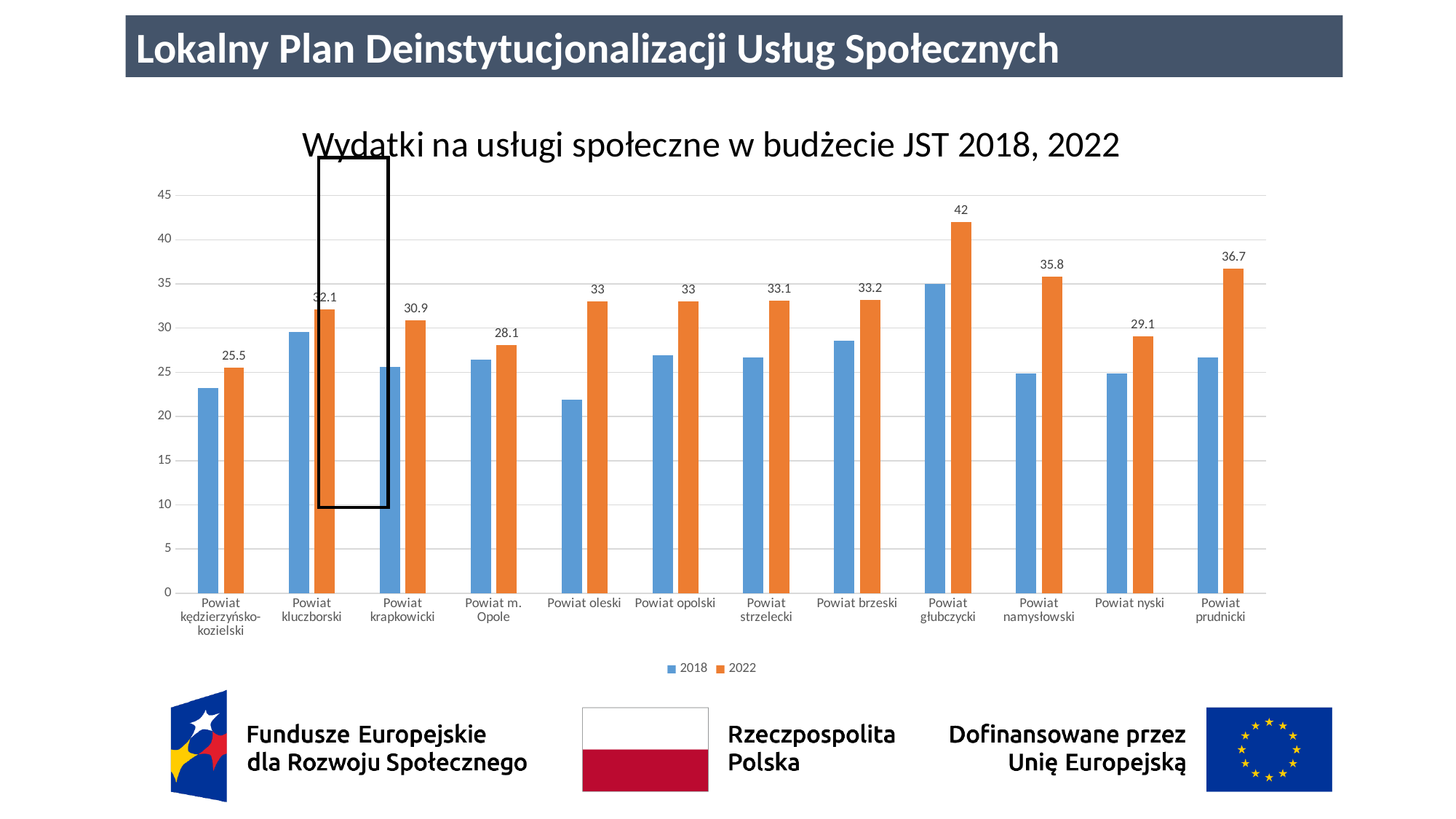
Is the 2018 value for Powiat oleski greater or less than 25? less How many series does the legend list? 2 What is the 2022 value for Powiat nyski? 29.1 What is the title of the chart? Wydatki na usługi społeczne w budżecie JST 2018, 2022 What is the difference between the 2022 values for Powiat głubczycki and Powiat kędzierzyńsko-kozielski? 16.5 Which powiat has the lowest 2022 value? Powiat kędzierzyńsko-kozielski What is the 2022 value for Powiat kluczborski? 32.1 How many powiats (categories) are shown on the x axis? 12 Which powiat has the highest 2022 value? Powiat głubczycki What type of chart is shown on the slide? bar chart What is the 2022 value for Powiat głubczycki? 42 Which has the larger 2022 value, Powiat prudnicki or Powiat namysłowski? Powiat prudnicki